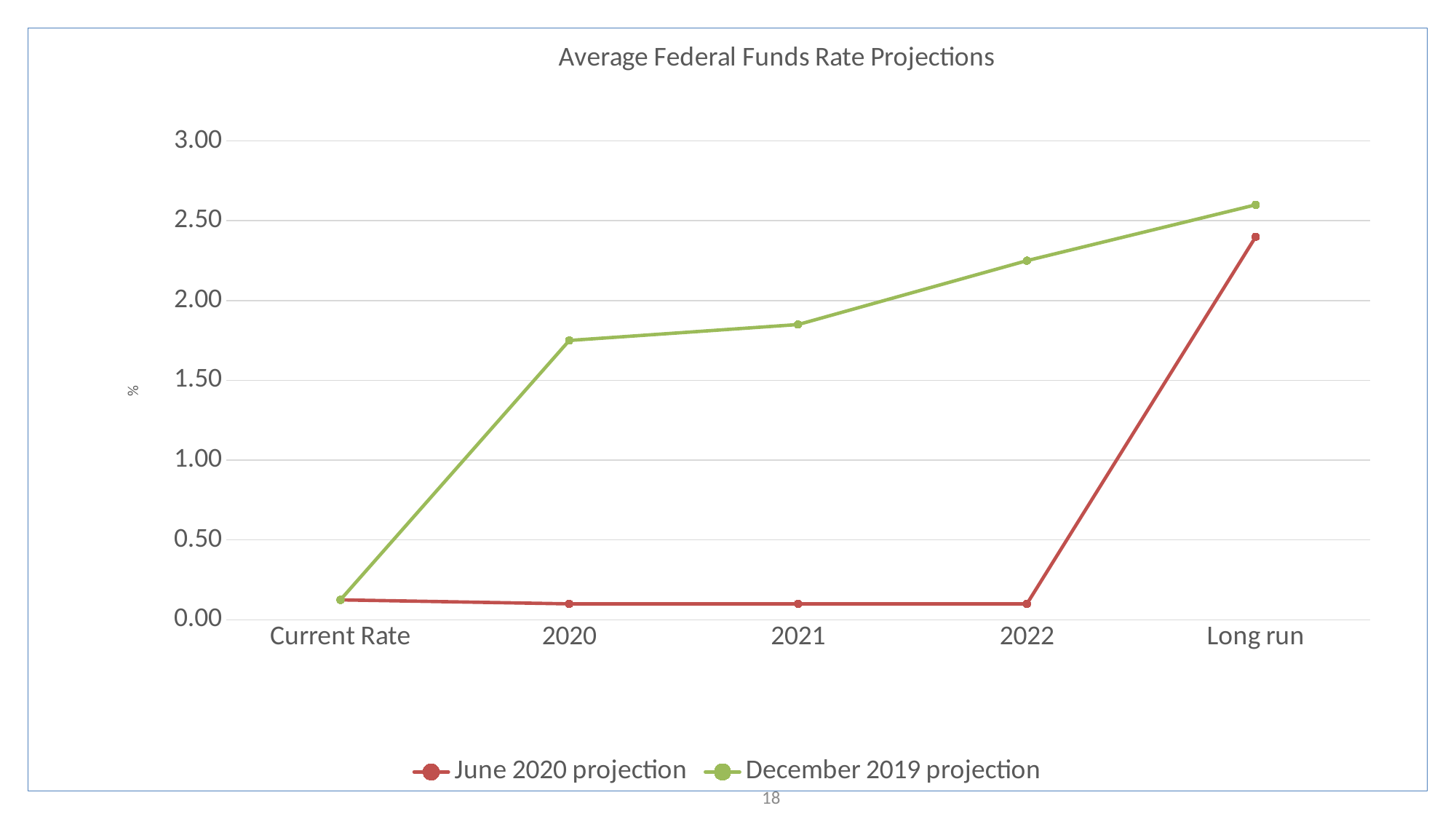
For the December 2019 projection, which category has the highest value? Long run Is the December 2019 projection value for 2020 greater or less than 1.50? greater Is the June 2020 projection value for Long run greater or less than 2.00? greater How many series does the legend list? 2 For the December 2019 projection, which category has the lowest value? Current Rate Is the December 2019 projection value for 2022 greater or less than 2.00? greater At 2021, which series has the higher value, June 2020 projection or December 2019 projection? December 2019 projection What is the title of the chart? Average Federal Funds Rate Projections What type of chart is shown on the slide? line chart What label is shown on the vertical axis? % How many categories are shown on the x axis? 5